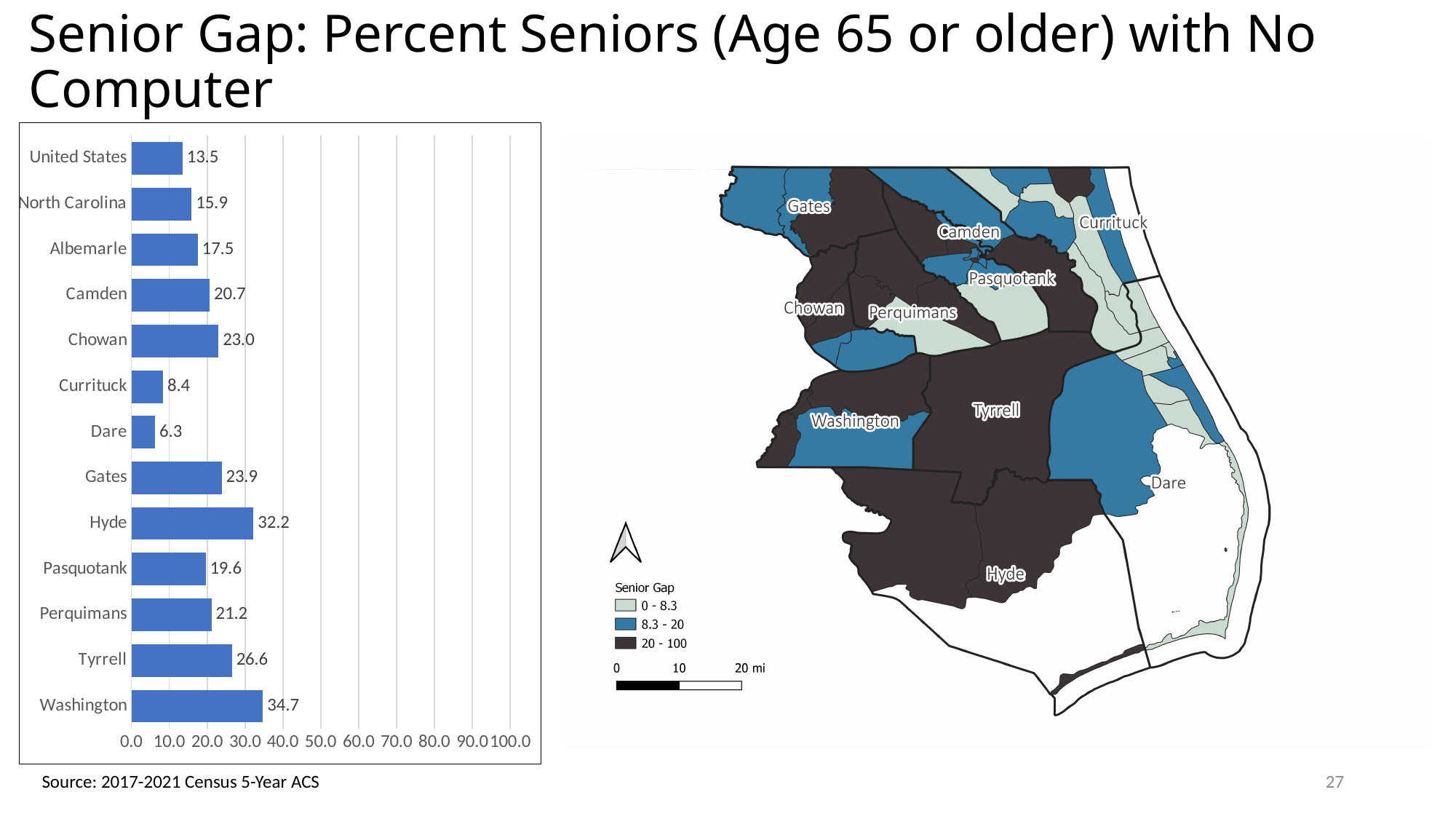
What kind of chart is shown on the left of the slide? bar chart What is the highest value shown on the x axis of the bar chart? 100.0 Which category has the highest value in the bar chart? Washington What is the value for Hyde in the bar chart? 32.2 What is the value for the United States in the bar chart? 13.5 How many categories are shown in the bar chart? 13 Which category has the lowest value in the bar chart? Dare Is the value for Chowan in the bar chart greater or less than 20.0? greater What is the difference between the values for North Carolina and the United States in the bar chart? 2.4 What is the value for Washington in the bar chart? 34.7 Which has a larger value in the bar chart, Tyrrell or Gates? Tyrrell What is the difference between the values for Washington and Dare in the bar chart? 28.4